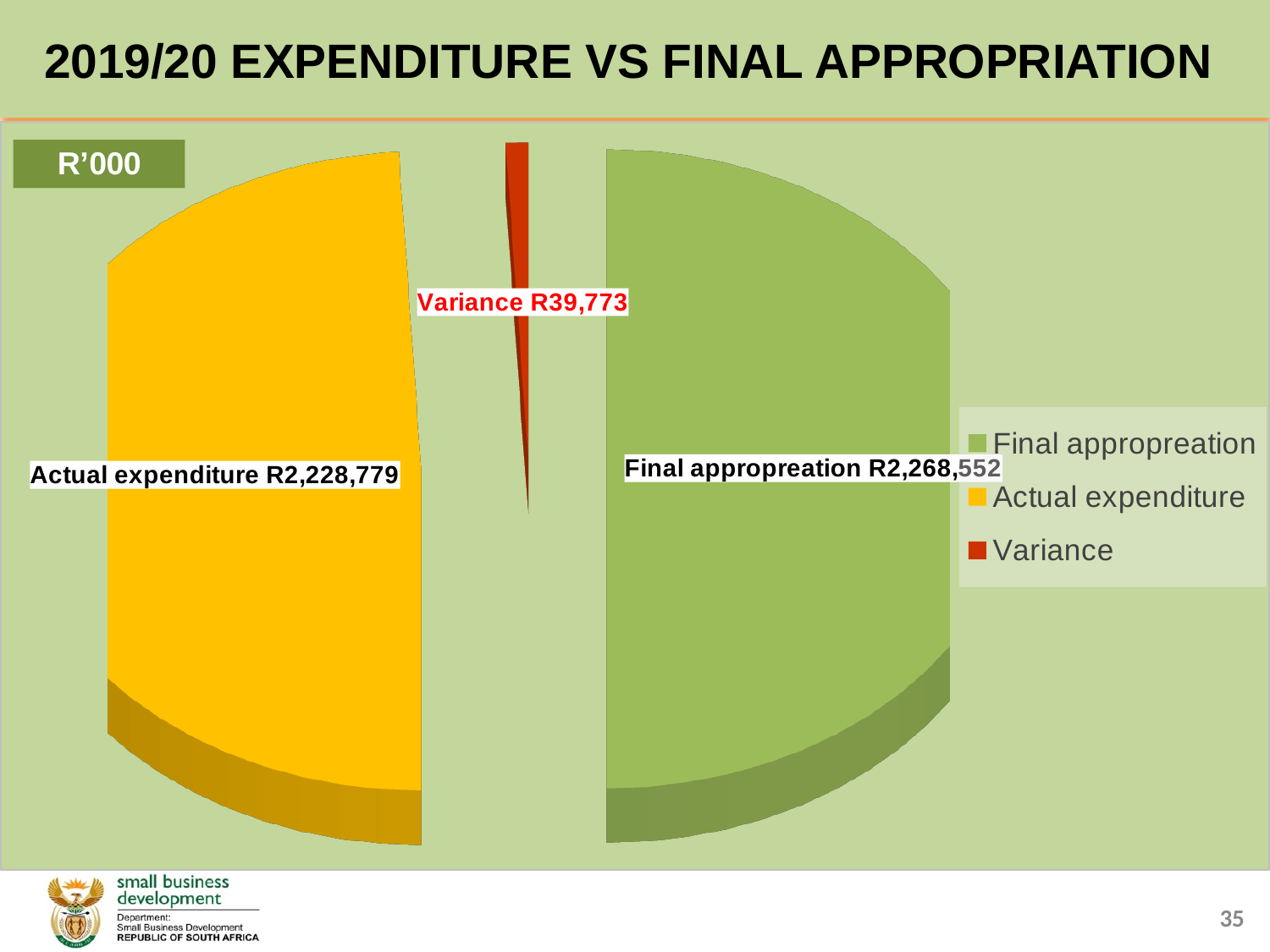
What is the value of the Actual expenditure slice? R2,228,779 How many entries does the legend list? 3 What is the value of the Variance slice? R39,773 What is the difference between the Final appropreation and Actual expenditure values? R39,773 What colour is the Variance slice in the legend? Red Which is larger, Actual expenditure or Final appropreation? Final appropreation Which slice of the pie is the smallest? Variance Which slice of the pie is the largest? Final appropreation What is the value of the Final appropreation slice? R2,268,552 What kind of chart is shown on the slide? Pie chart What unit label is shown in the box at the top left of the chart? R'000 How many slices does the pie chart have? 3